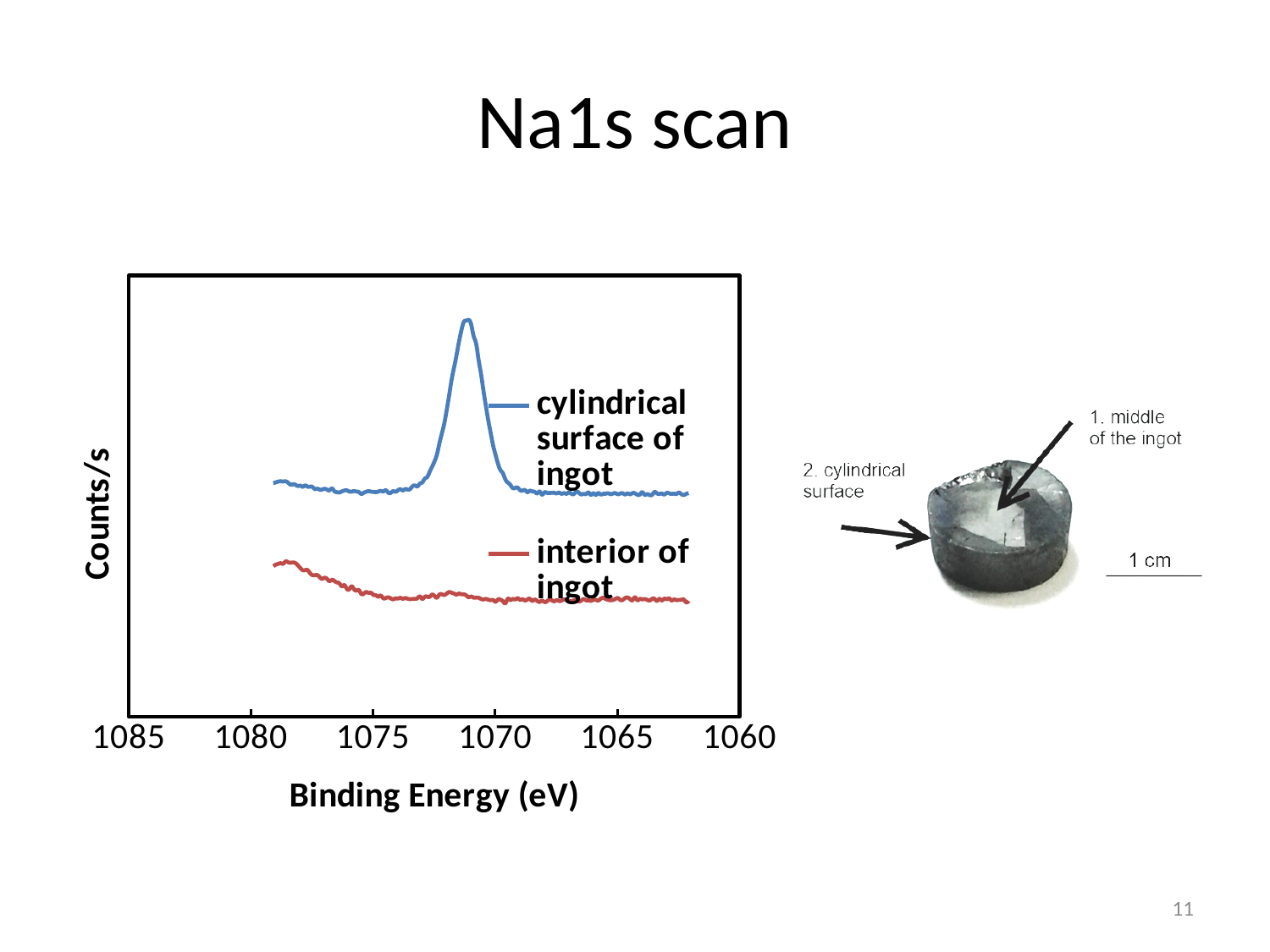
Is the peak of the cylindrical surface of ingot series at a binding energy greater or less than 1075 eV? less Is the peak of the cylindrical surface of ingot series at a binding energy greater or less than 1070 eV? greater Which series shows a prominent peak, cylindrical surface of ingot or interior of ingot? cylindrical surface of ingot What kind of chart is shown on the slide? line chart Does the interior of ingot series rise or fall as binding energy goes from 1079 eV to 1075 eV? fall What is the label of the x axis of the chart? Binding Energy (eV) What colour is the line for the interior of ingot series? red Which series is plotted higher on the Counts/s axis, cylindrical surface of ingot or interior of ingot? cylindrical surface of ingot How many series does the legend of the chart list? 2